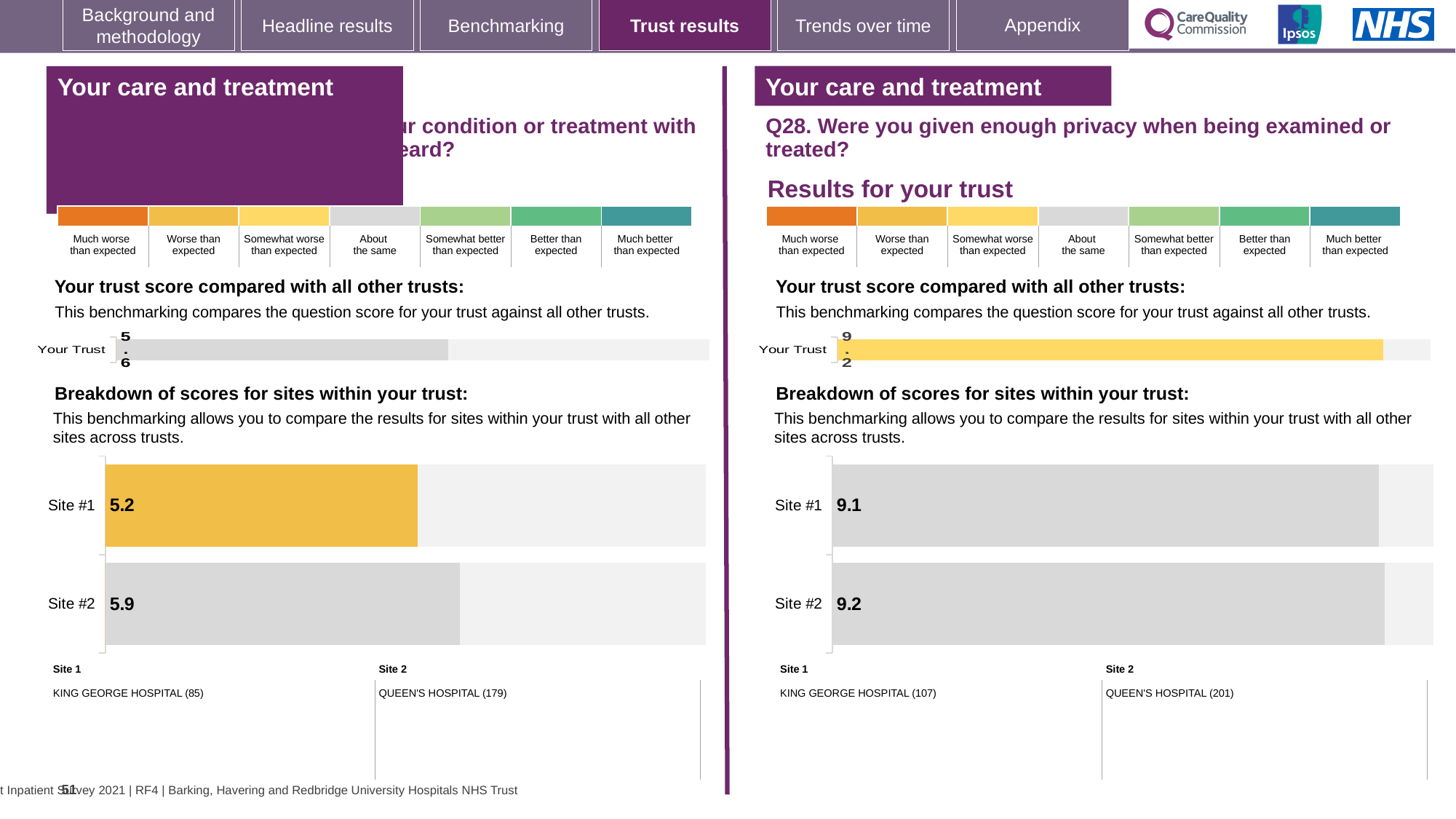
How many sites are shown in the right-hand site breakdown chart (Q28)? 2 On the right-hand chart (Q28), what is the score for Site #2? 9.2 On the right-hand site breakdown chart (Q28), what is the difference between the Site #2 and Site #1 scores? 0.1 On the left-hand chart, what is the score for Site #2? 5.9 On the left-hand site breakdown chart, what colour is the Site #1 bar? Yellow/orange On the left-hand panel, what is the trust score shown in the 'Your Trust' bar? 5.6 What kind of chart is used for the site breakdown on the right-hand panel (Q28)? Bar chart On the left-hand site breakdown chart, which site has the higher score? Site #2 On the right-hand panel (Q28), what is the trust score shown in the 'Your Trust' bar? 9.2 On the left-hand chart, what is the score for Site #1? 5.2 On the right-hand chart (Q28), what is the score for Site #1? 9.1 On the left-hand site breakdown chart, what is the difference between the Site #2 and Site #1 scores? 0.7